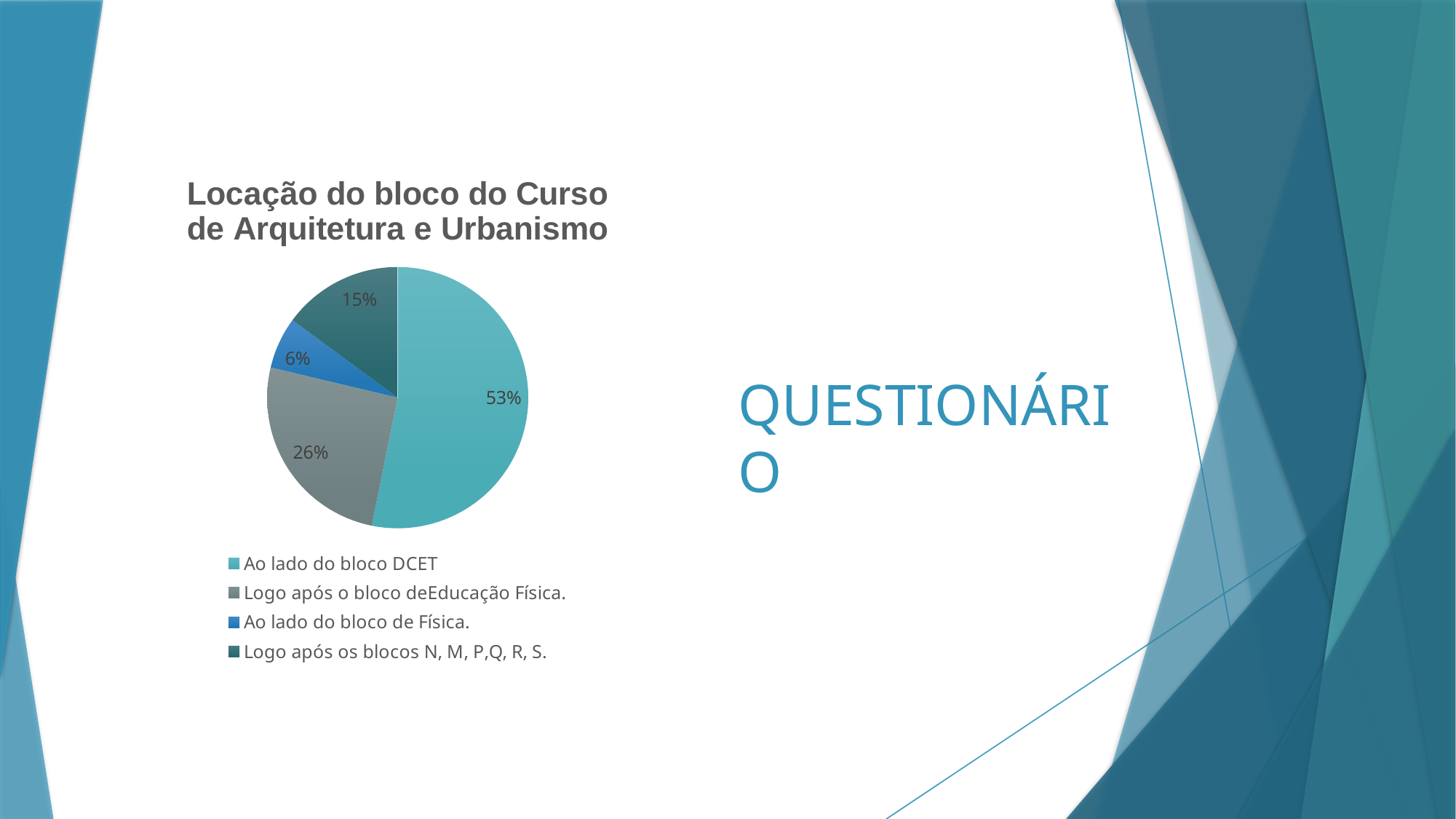
What is the title of the chart? Locação do bloco do Curso de Arquitetura e Urbanismo What kind of chart is shown on the slide? pie chart What percentage of the pie is 'Ao lado do bloco DCET'? 53% What is the difference in percentage points between 'Logo após os blocos N, M, P,Q, R, S.' and 'Ao lado do bloco de Física.'? 9 Which is larger: the share for 'Logo após os blocos N, M, P,Q, R, S.' or the share for 'Ao lado do bloco de Física.'? Logo após os blocos N, M, P,Q, R, S. Which category has the largest share of the pie? Ao lado do bloco DCET What is the difference in percentage points between 'Ao lado do bloco DCET' and 'Logo após o bloco deEducação Física.'? 27 Which category has the smallest share of the pie? Ao lado do bloco de Física. What percentage of the pie is 'Logo após o bloco deEducação Física.'? 26% How many categories does the pie chart have? 4 What percentage of the pie is 'Ao lado do bloco de Física.'? 6% What percentage of the pie is 'Logo após os blocos N, M, P,Q, R, S.'? 15%